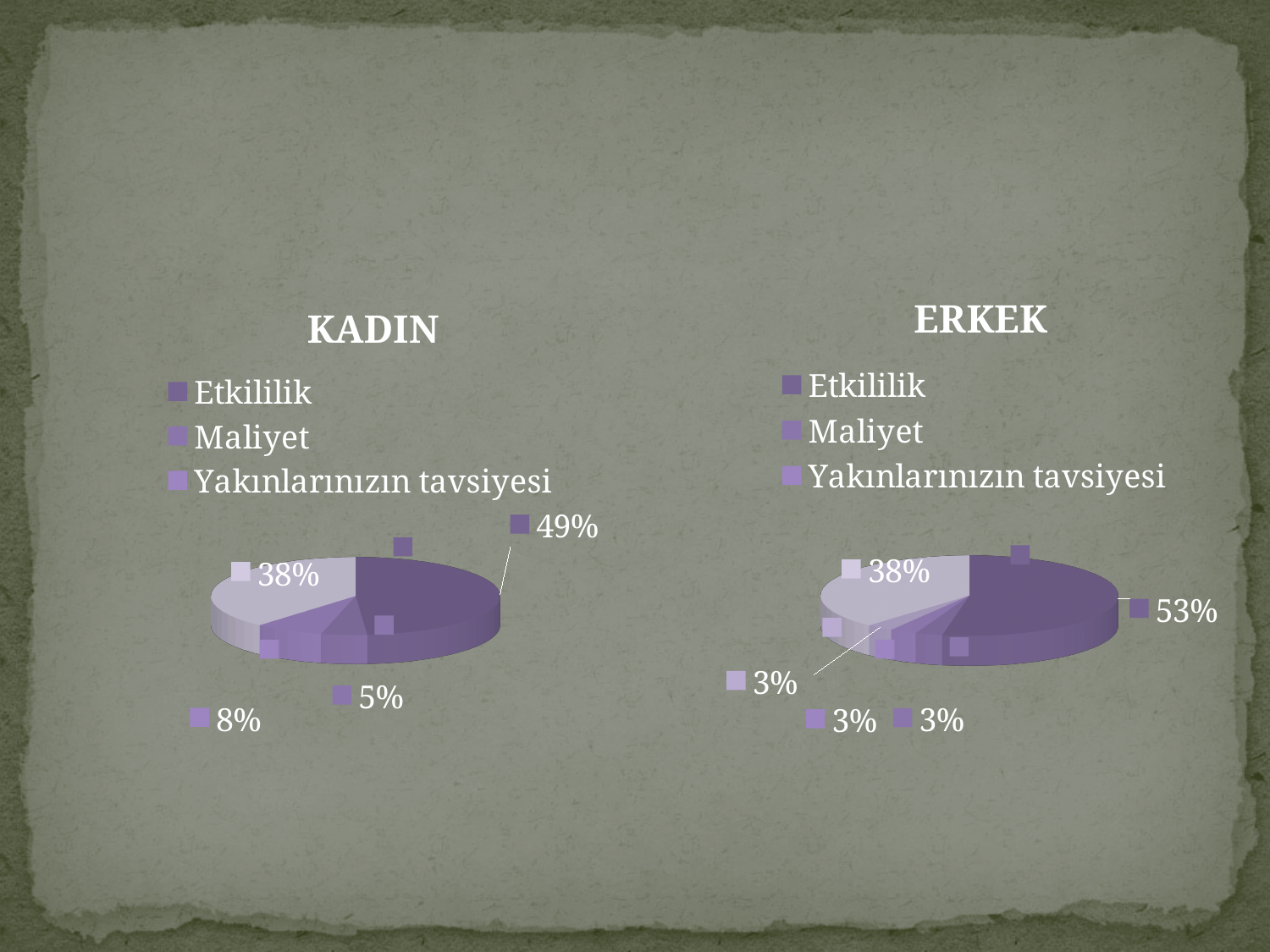
How many slices does the KADIN pie chart have? 4 How many entries does the legend of the ERKEK chart list? 3 In the KADIN chart, what is the value of the smallest slice? 5% What is the difference between the Etkililik share in the ERKEK chart and in the KADIN chart? 4 percentage points In the ERKEK chart, what percentage is shown for Etkililik? 53% What kind of chart is the KADIN chart? pie chart In the ERKEK chart, what is the value of the largest slice? 53% In the KADIN chart, what percentage is shown for Etkililik? 49% How many slices does the ERKEK pie chart have? 5 In the KADIN chart, what is the difference between the 49% slice and the 38% slice? 11 percentage points Which chart shows a larger share for Etkililik, KADIN or ERKEK? ERKEK In the KADIN chart, what is the value of the largest slice? 49%